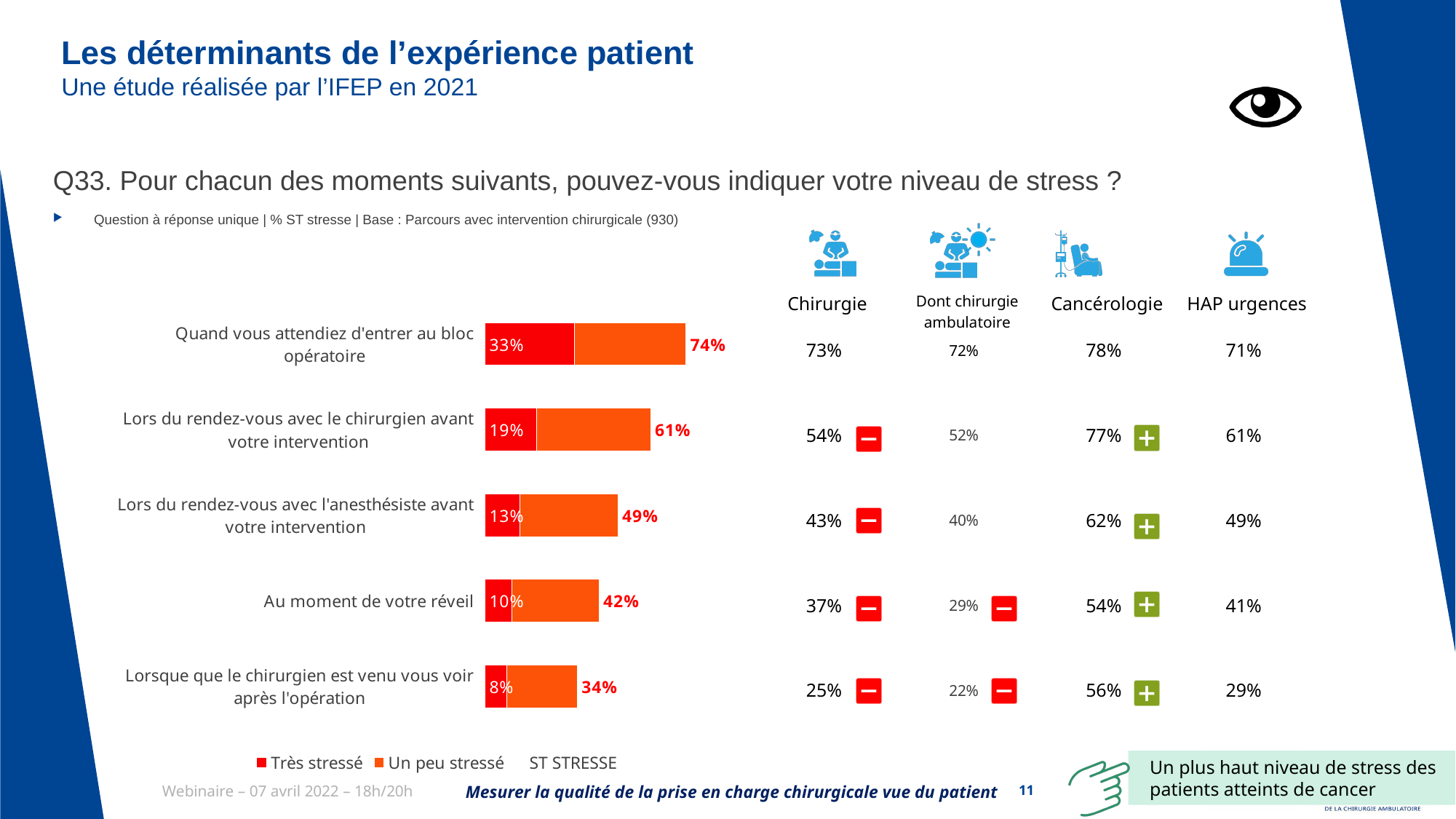
What is the difference between the ST STRESSE values for 'Quand vous attendiez d'entrer au bloc opératoire' and 'Lors du rendez-vous avec le chirurgien avant votre intervention'? 13% Do the ST STRESSE values rise or fall going down the list of moments from top to bottom? fall What is the ST STRESSE value for 'Au moment de votre réveil'? 42% Which colour represents the 'Très stressé' series in the chart? red What is the 'Très stressé' value for 'Quand vous attendiez d'entrer au bloc opératoire'? 33% Which moment has the lowest 'Très stressé' value? Lorsque que le chirurgien est venu vous voir après l'opération How many moments (categories) are plotted in the bar chart? 5 Which moment has the highest ST STRESSE value? Quand vous attendiez d'entrer au bloc opératoire Which is larger: the 'Très stressé' value for 'Lors du rendez-vous avec l'anesthésiste avant votre intervention' or for 'Au moment de votre réveil'? Lors du rendez-vous avec l'anesthésiste avant votre intervention How many series does the chart legend list? 3 What type of chart is shown on the slide? bar chart What is the 'Très stressé' value for 'Lorsque que le chirurgien est venu vous voir après l'opération'? 8%